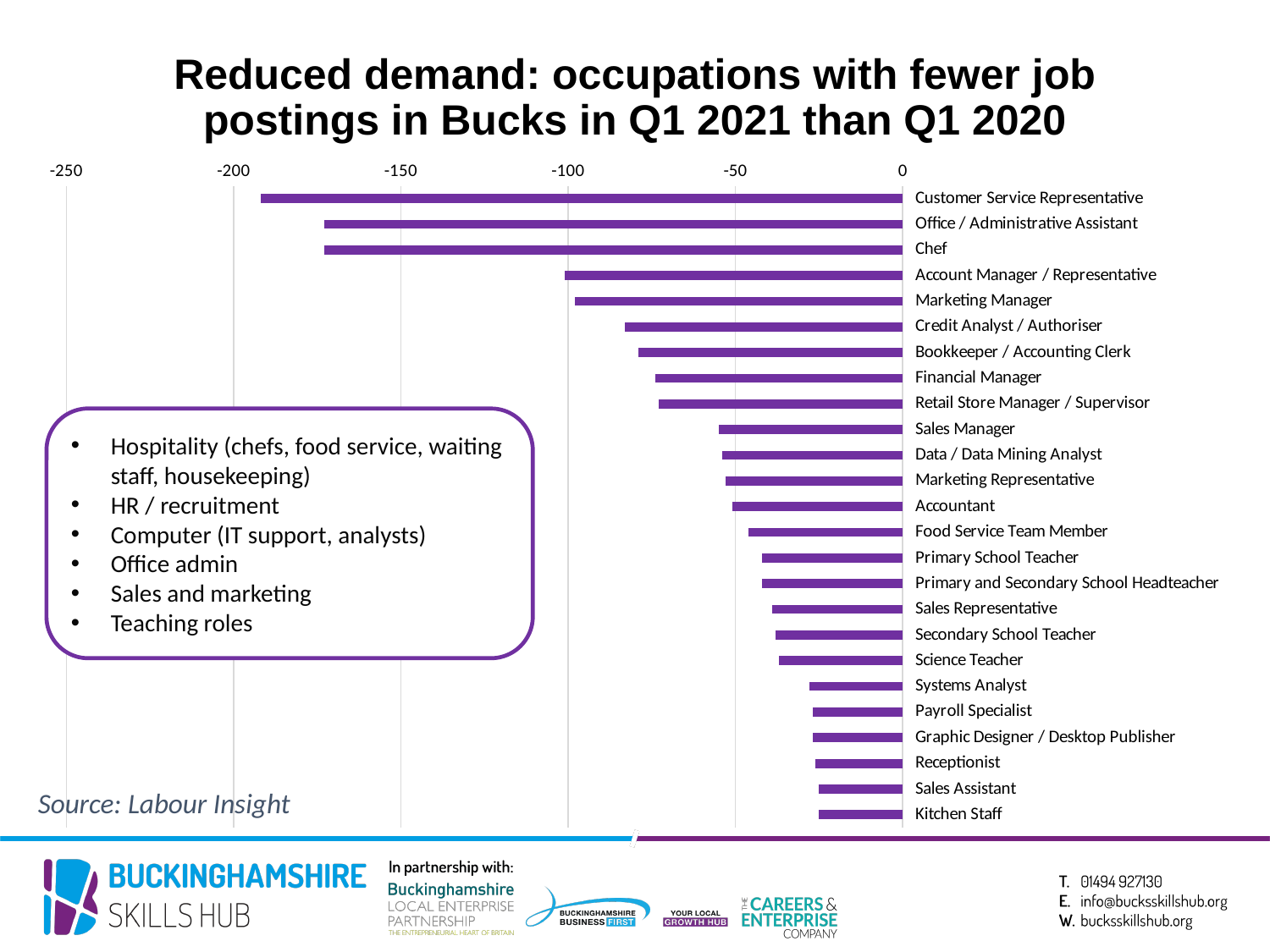
Which has the larger reduction in job postings, Customer Service Representative or Chef? Customer Service Representative Is the value for Credit Analyst / Authoriser greater or less than -100? greater Is the value for Primary School Teacher greater or less than -50? greater Is the value for Customer Service Representative greater or less than -150? less How many occupations are listed in the chart? 25 Which has the larger reduction in job postings, Credit Analyst / Authoriser or Sales Manager? Credit Analyst / Authoriser What is the title of the chart? Reduced demand: occupations with fewer job postings in Bucks in Q1 2021 than Q1 2020 What kind of chart is shown on the slide? bar chart Which occupation shows the largest reduction in job postings (the longest bar)? Customer Service Representative What is the source cited for the chart data? Labour Insight